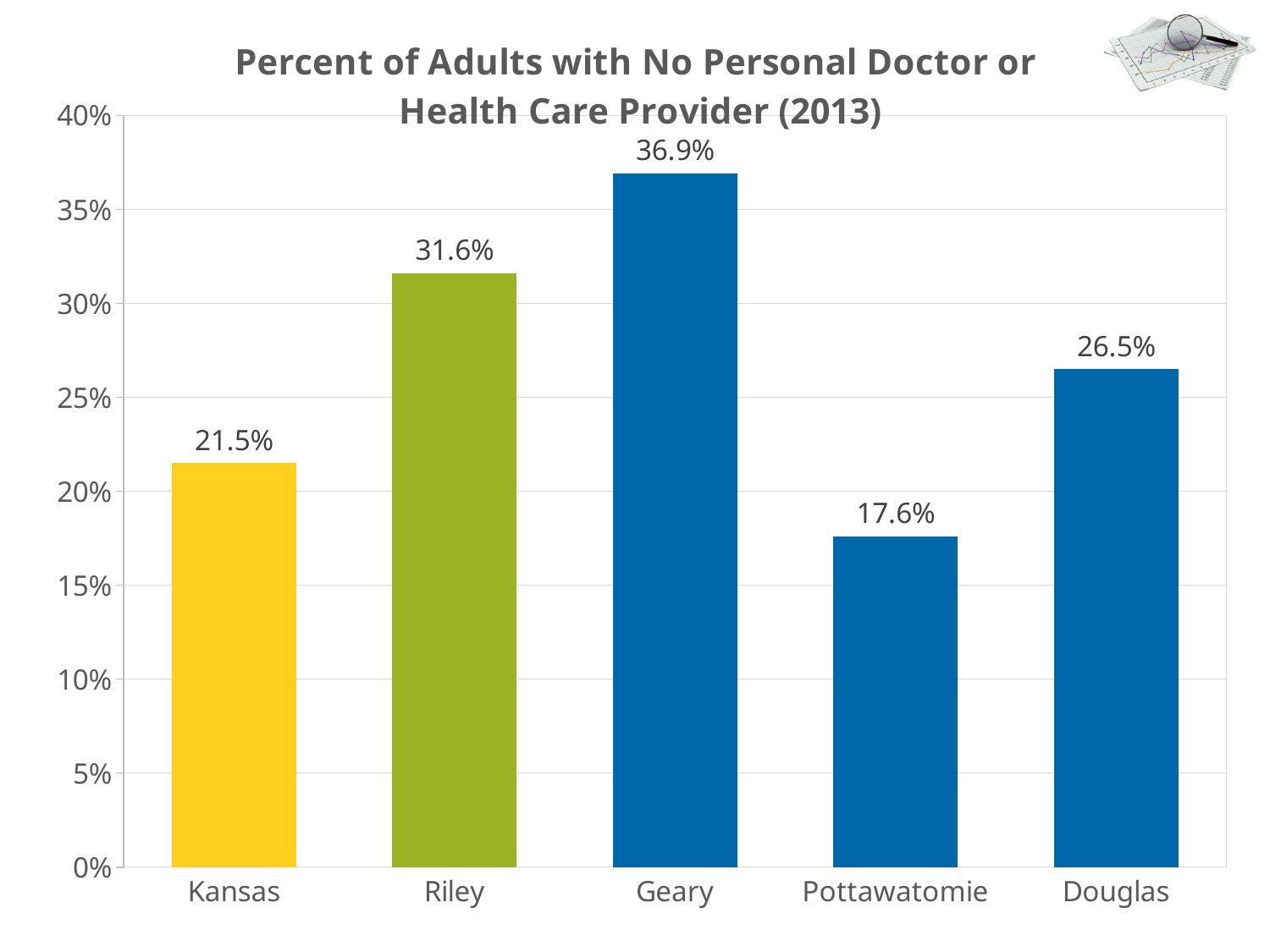
What is the value for Riley? 31.6% What is the difference between the values for Geary and Kansas? 15.4% Which is larger, the value for Riley or the value for Douglas? Riley What is the value for Douglas? 26.5% What is the value for Kansas? 21.5% What is the value for Pottawatomie? 17.6% Which category has the lowest value? Pottawatomie Is the value for Geary greater or less than 35%? greater Which category has the highest value? Geary What is the title of the chart? Percent of Adults with No Personal Doctor or Health Care Provider (2013) How many categories are shown on the x axis? 5 What kind of chart is this? bar chart